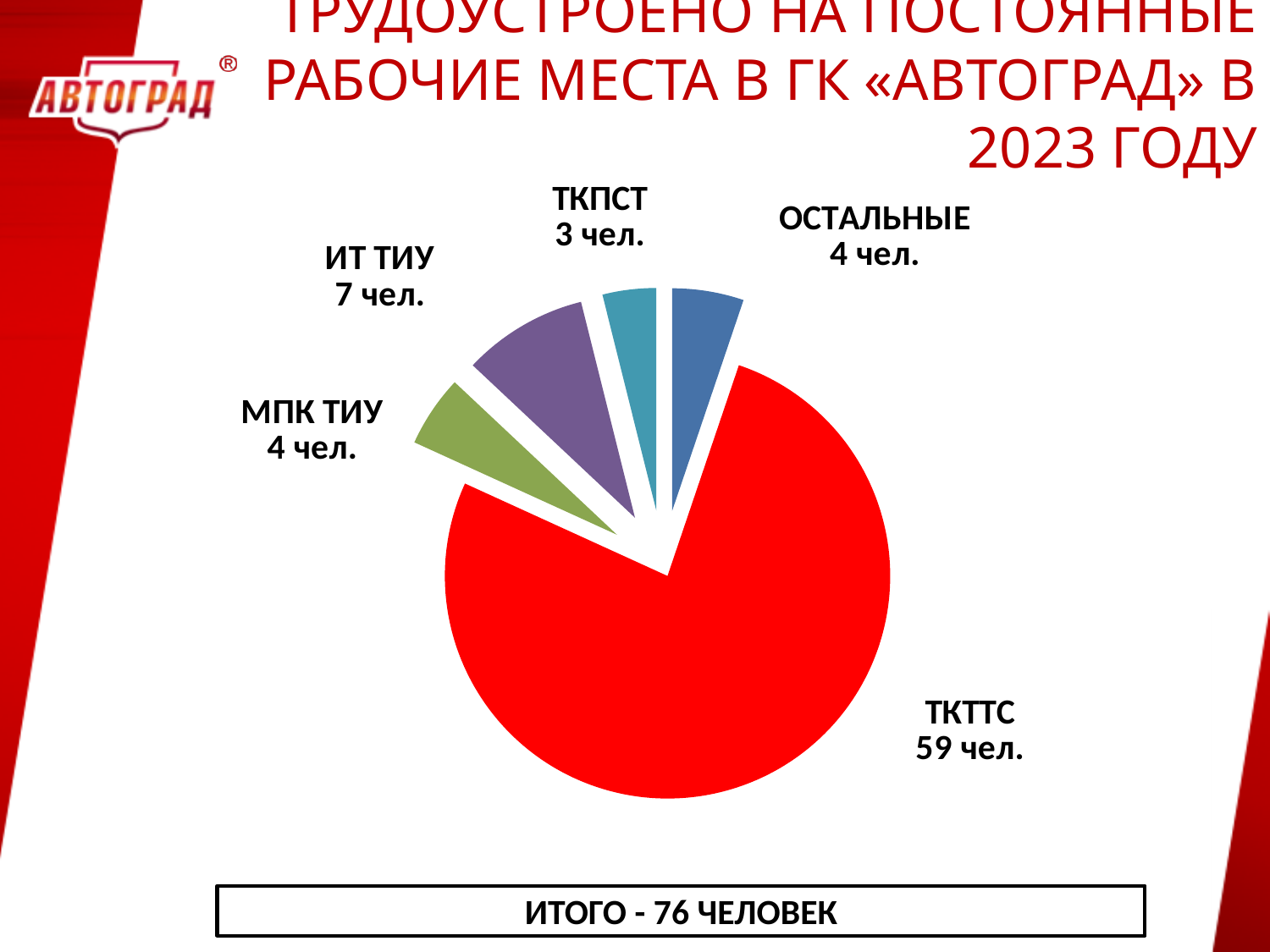
What kind of chart is shown on the slide? pie chart What colour is the ТКТТС slice of the pie? red What is the value shown for ТКПСТ? 3 чел. What is the value shown for МПК ТИУ? 4 чел. What is the difference between the values for ТКТТС and ИТ ТИУ? 52 чел. How many slices does the pie chart have? 5 How many people does the ТКТТС slice represent? 59 чел. Which is larger, the value for ИТ ТИУ or the value for МПК ТИУ? ИТ ТИУ Which category has the smallest slice of the pie? ТКПСТ What is the value shown for ИТ ТИУ? 7 чел. What total number of people is stated at the bottom of the slide? 76 человек Which category has the largest slice of the pie? ТКТТС